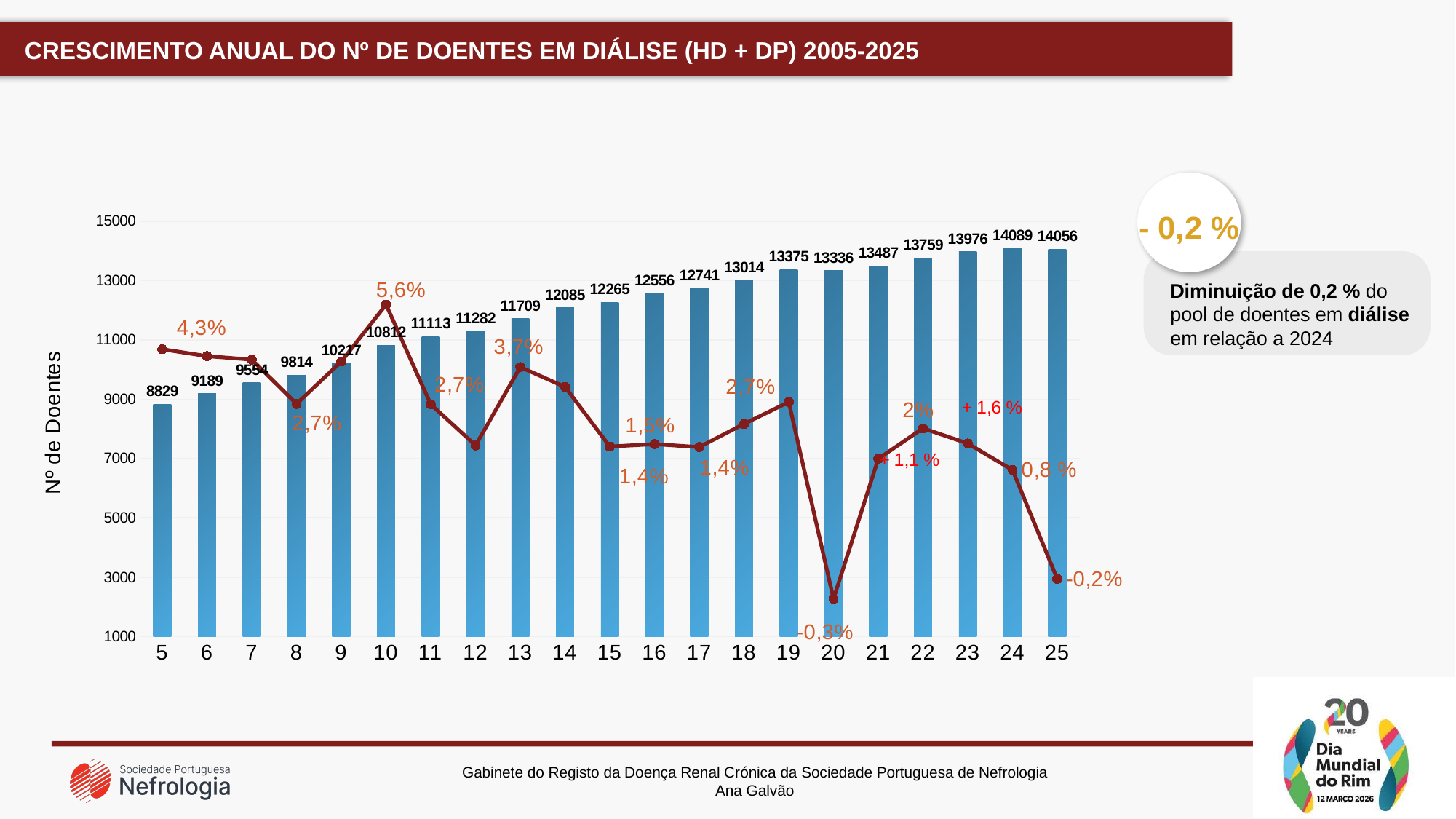
How many categories are shown on the x axis? 21 What is the difference between the bar values for categories 24 and 25? 33 Which category has the lowest bar value? 5 Which bar is larger, category 19 or category 20? 19 What is the value of the bar for category 25? 14056 What is the difference between the bar values for categories 10 and 9? 595 What is the value of the bar for category 15? 12265 Is the bar value for category 12 greater or less than 11000? greater What is the value of the bar for category 5? 8829 Which category has the highest bar value? 24 What growth percentage is labelled on the line at category 10? 5,6% What is the title of the y axis? Nº de Doentes